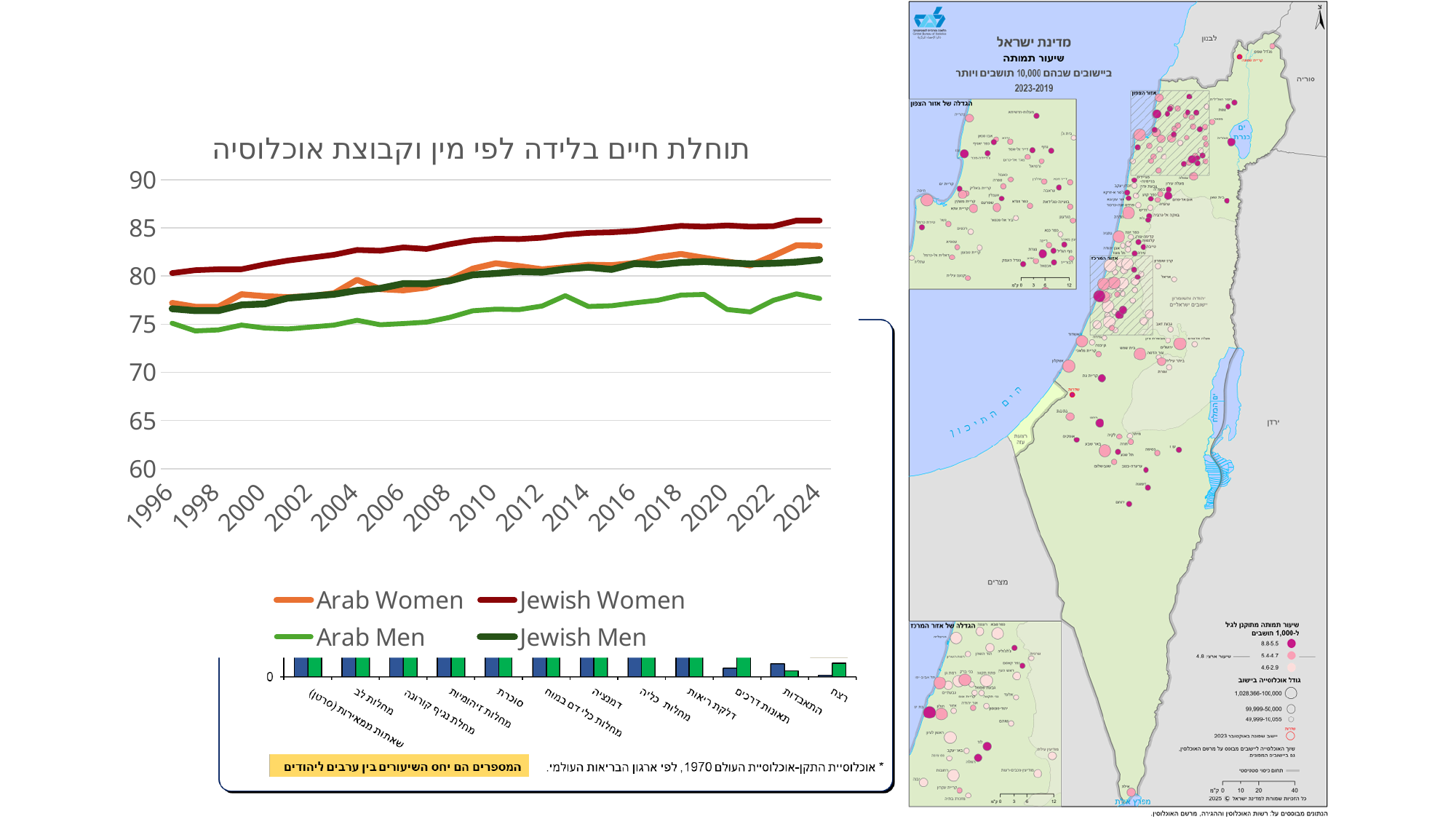
What kind of chart is the chart titled 'תוחלת חיים בלידה לפי מין וקבוצת אוכלוסיה'? line chart In the life expectancy line chart, is the value for Arab Women in 2024 greater or less than 80? greater In the life expectancy line chart, is the value for Jewish Women in 2024 greater or less than 85? greater In the life expectancy line chart, does the Jewish Women series rise or fall from 1996 to 2024? rise In the life expectancy line chart, how many year labels are shown on the x axis? 15 In the life expectancy line chart, which series has the highest values across the whole period? Jewish Women In the life expectancy line chart, how many series does the legend list? 4 In the life expectancy line chart, which is higher in 2024: Jewish Men or Arab Men? Jewish Men In the life expectancy line chart, which series has the lowest values across the whole period? Arab Men In the life expectancy line chart, which series is drawn in orange? Arab Women In the life expectancy line chart, is the value for Arab Men in 2024 greater or less than 80? less